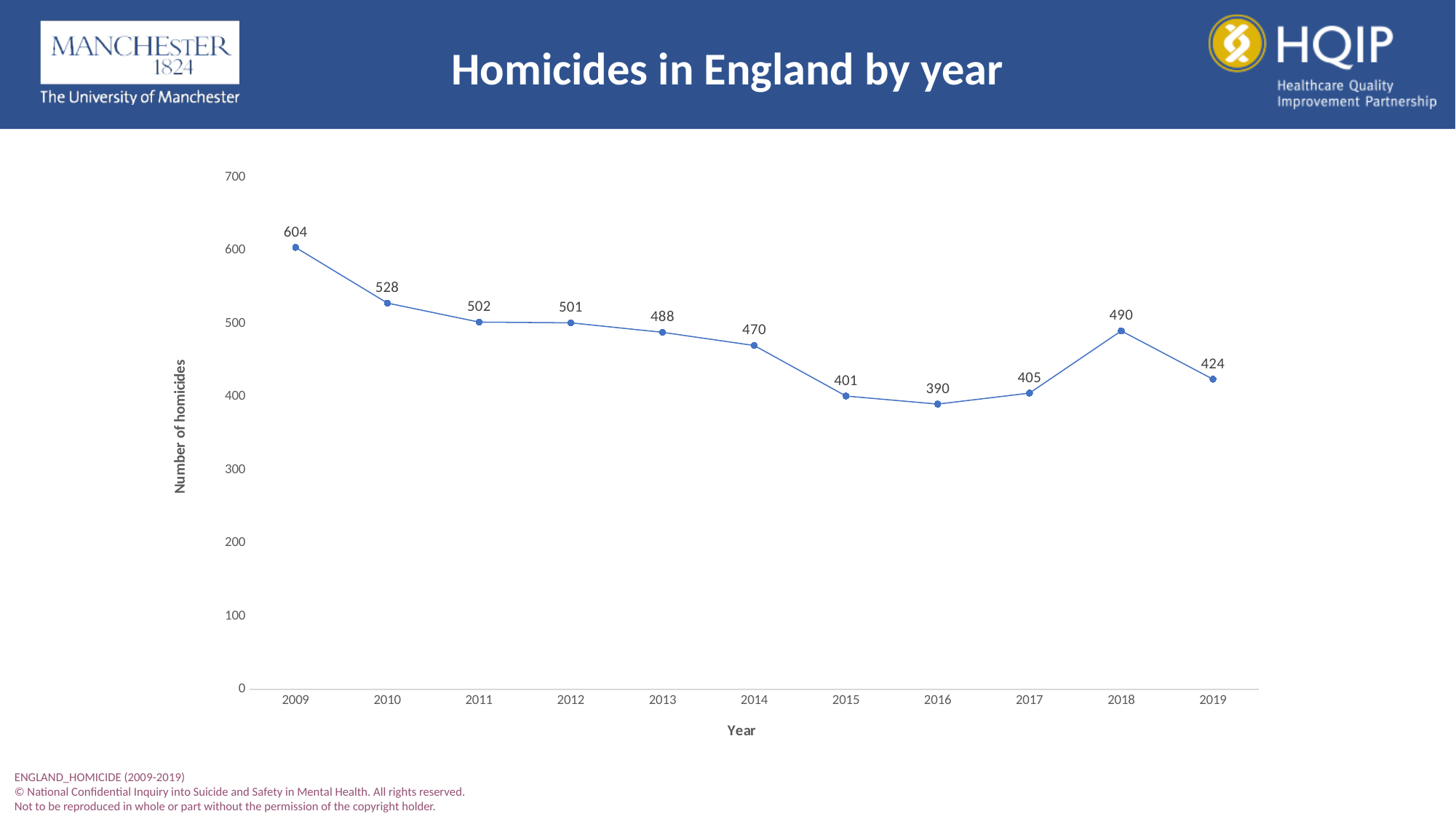
What is the number of homicides in 2016? 390 What is the number of homicides in 2018? 490 What is the difference in the number of homicides between 2009 and 2019? 180 Which year has the lowest number of homicides? 2016 How many years are plotted on the chart? 11 What is the label of the y axis? Number of homicides Which year has the highest number of homicides? 2009 What is the number of homicides in 2009? 604 Which year had more homicides, 2014 or 2015? 2014 What is the difference in the number of homicides between 2018 and 2017? 85 What kind of chart is shown on the slide? Line chart Is the value for 2013 greater or less than 400? greater